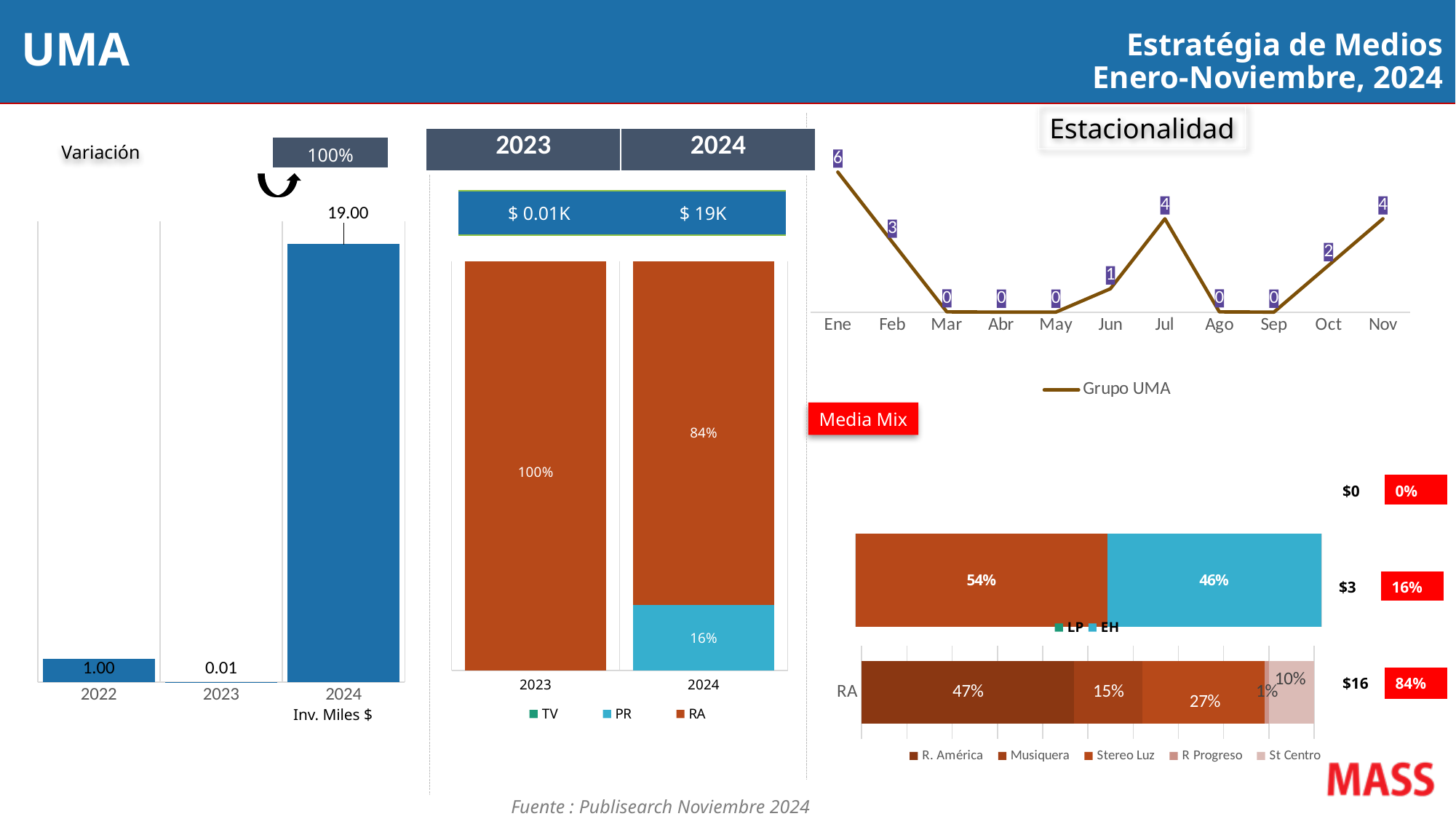
In the 'Inv. Miles $' bar chart on the left, what is the value for 2024? 19.00 In the 'Estacionalidad' line chart, what is the value for Jul? 4 In the 'Estacionalidad' line chart, what is the difference between the Ene and Feb values? 3 In the 'Inv. Miles $' bar chart on the left, which year has the highest value? 2024 In the stacked bar chart comparing 2023 and 2024 in the middle, what share does PR have in 2024? 16% In the 'Estacionalidad' line chart, how many months are plotted on the x axis? 11 In the stacked bar chart comparing 2023 and 2024 in the middle, what share does RA have in 2024? 84% How many series does the legend of the middle stacked bar chart list? 3 In the 'Inv. Miles $' bar chart on the left, what is the value for 2023? 0.01 In the 'Estacionalidad' line chart, which month has the highest value? Ene In the 'Media Mix' RA bar, which station has the largest share? R. América In the 'Inv. Miles $' bar chart on the left, what is the difference between the 2024 and 2022 values? 18.00